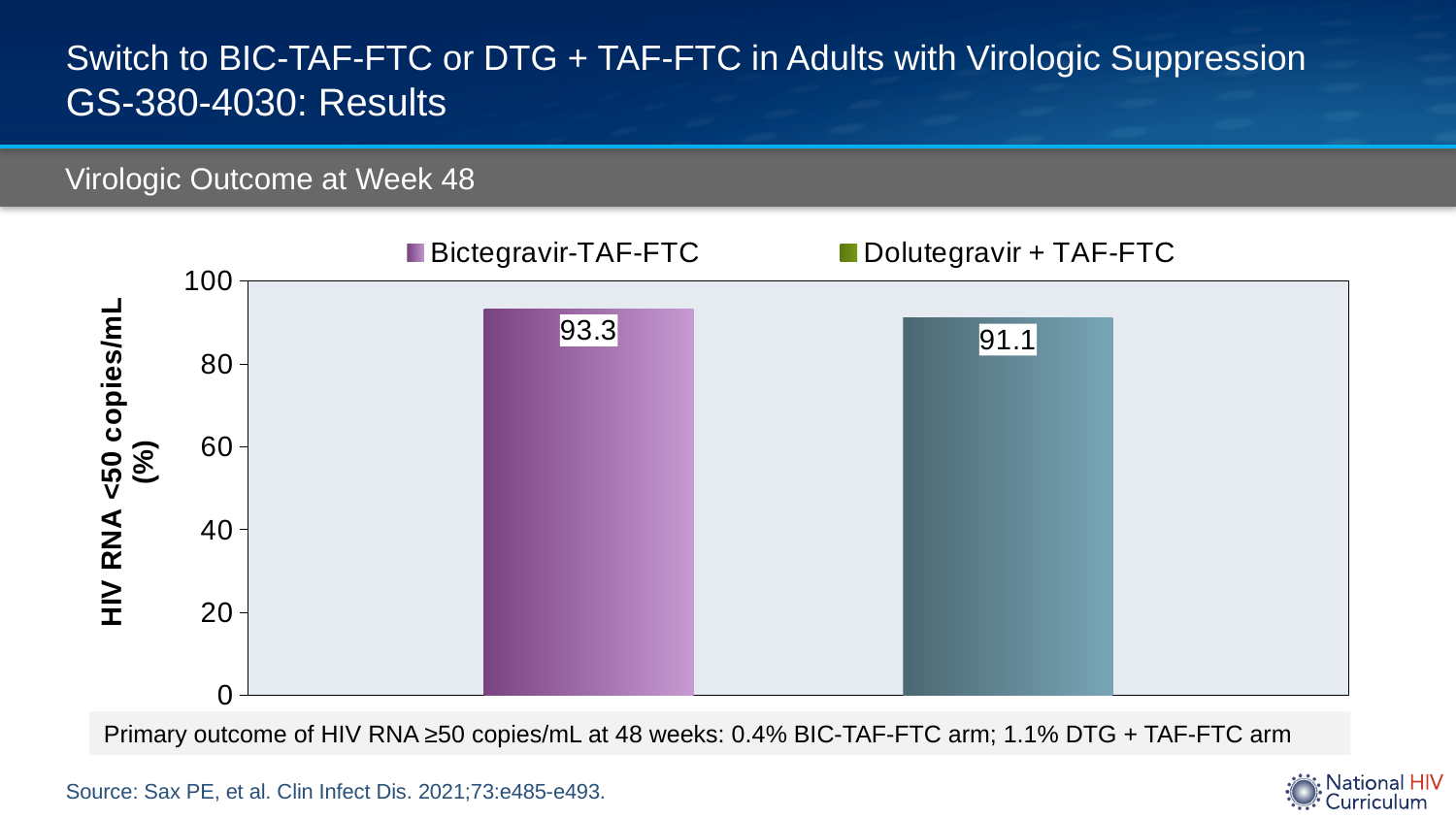
Which arm has the lower percentage with HIV RNA <50 copies/mL? Dolutegravir + TAF-FTC What is the value for Dolutegravir + TAF-FTC? 91.1 How many bars are plotted in the chart? 2 Which arm has the higher percentage with HIV RNA <50 copies/mL? Bictegravir-TAF-FTC What is the title of the chart? Virologic Outcome at Week 48 What is the difference between the Bictegravir-TAF-FTC and Dolutegravir + TAF-FTC values? 2.2 What kind of chart is shown on the slide? Bar chart What is the value for Bictegravir-TAF-FTC? 93.3 How many series does the legend list? 2 What is the label of the y axis? HIV RNA <50 copies/mL (%) Is the value for Bictegravir-TAF-FTC greater or less than 100? less Is the value for Dolutegravir + TAF-FTC greater or less than 80? greater